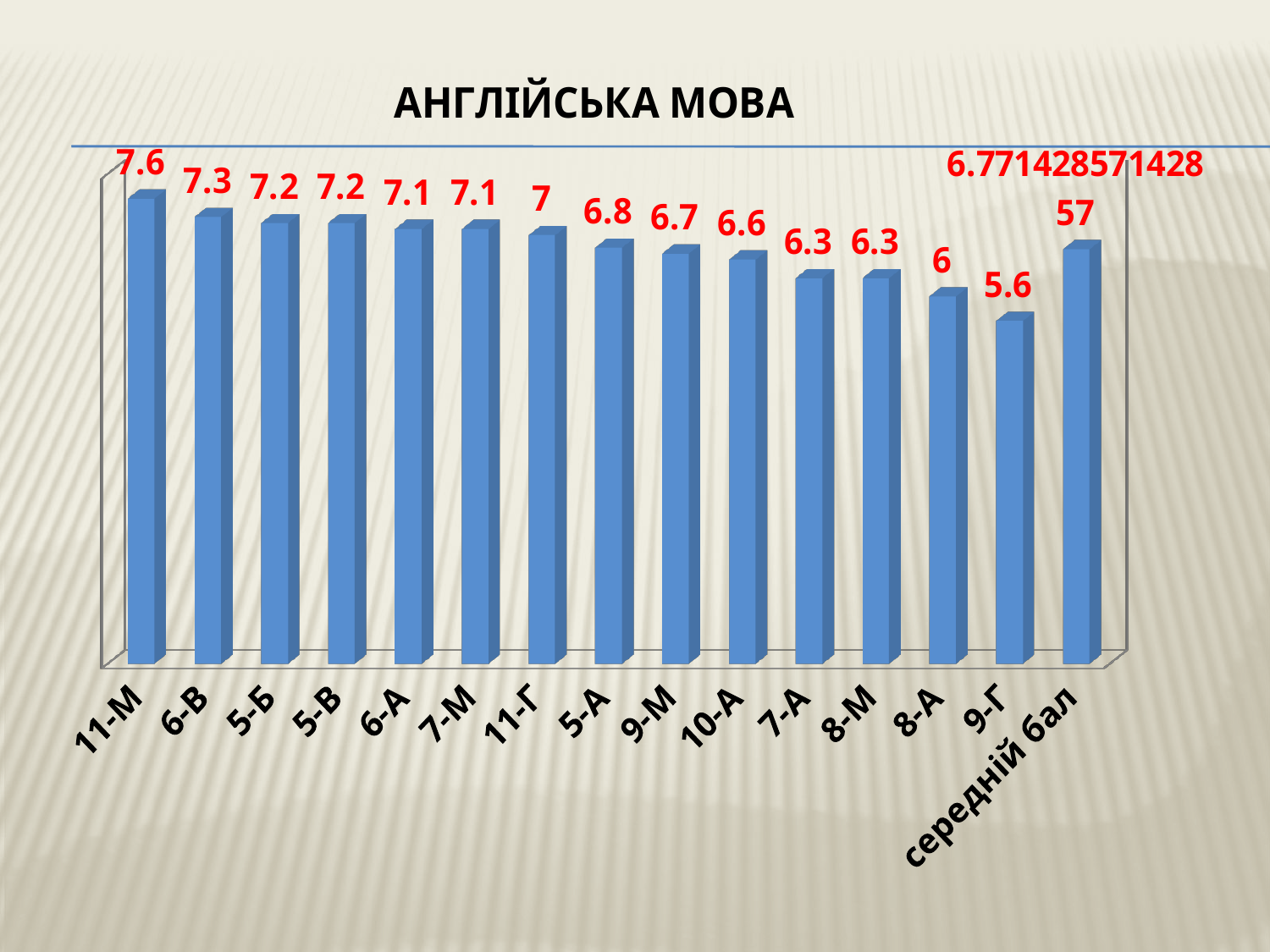
What is the difference between the values for 11-М and 9-Г? 2 Do the values generally rise or fall from 11-М to 9-Г along the x axis? fall Which category has the highest value? 11-М How many bars are shown in the chart? 15 What is the title of the chart? АНГЛІЙСЬКА МОВА What is the value for 11-М? 7.6 What is the value for 10-А? 6.6 What type of chart is shown on the slide? bar chart Which is larger, the value for 5-А or the value for 8-А? 5-А What is the value for 9-Г? 5.6 What is the value for 6-В? 7.3 Which category has the lowest value? 9-Г